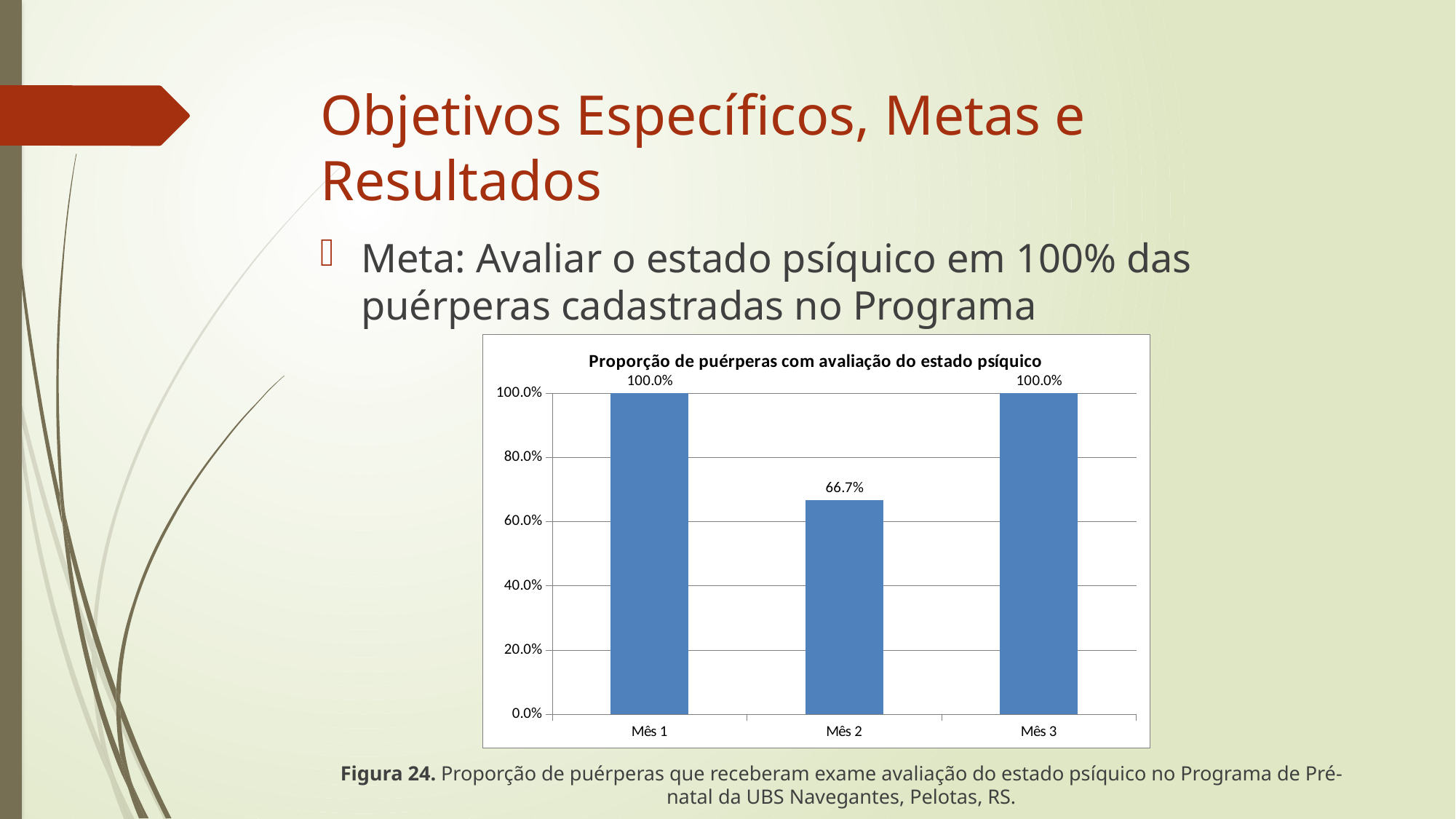
Which month has the lowest value? Mês 2 Does the value rise or fall from Mês 2 to Mês 3? rise How many months are shown on the x axis? 3 What is the title of the chart? Proporção de puérperas com avaliação do estado psíquico What is the difference between the values for Mês 1 and Mês 2? 33.3% Which is larger, the value for Mês 2 or the value for Mês 3? Mês 3 What kind of chart is shown on the slide? bar chart What is the value for Mês 3? 100.0% What is the value for Mês 2? 66.7% Is the value for Mês 2 greater or less than 80.0%? less What is the value for Mês 1? 100.0% What is the highest value shown on the y axis? 100.0%